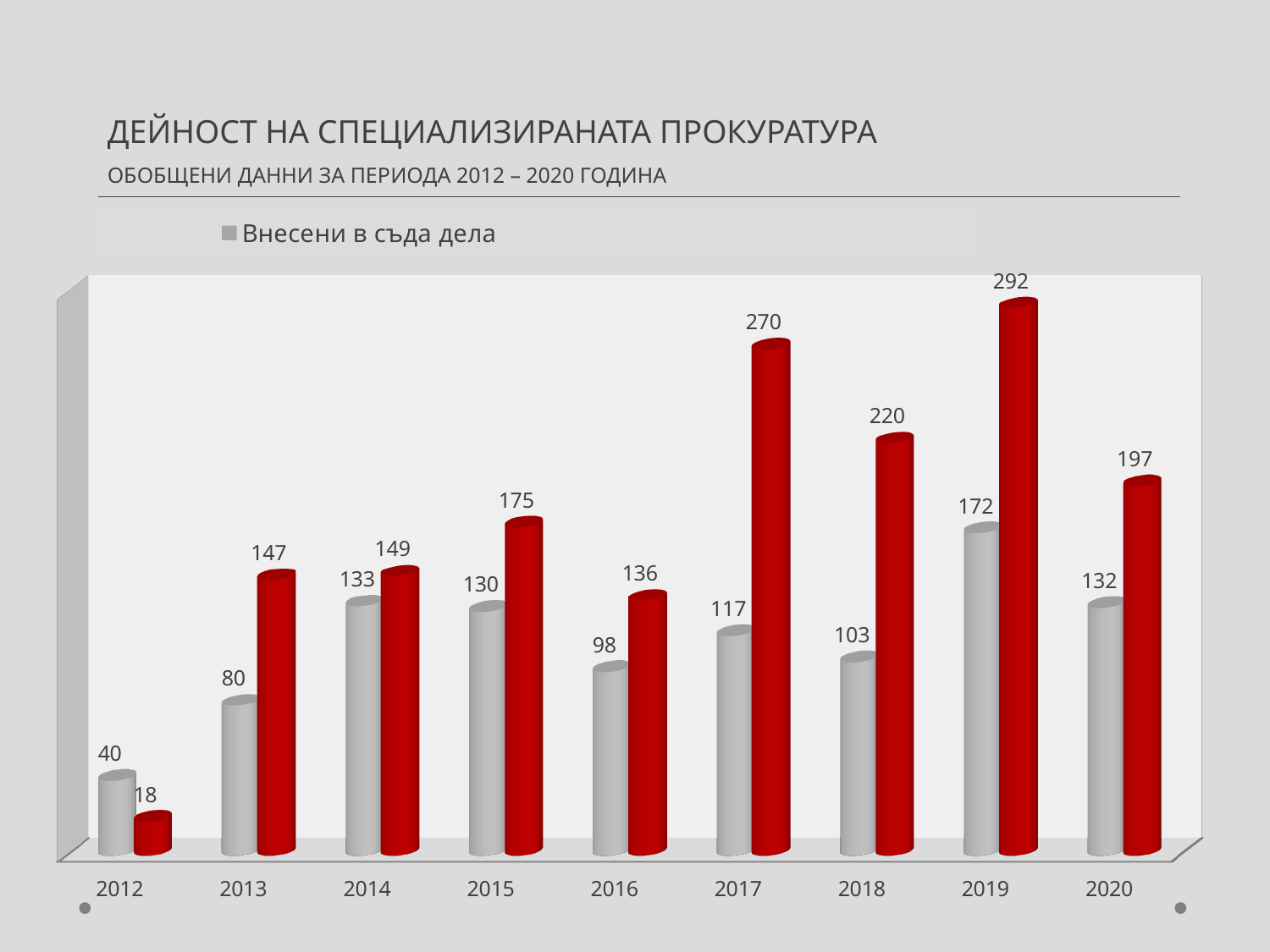
What is the value of the red bar for 2017? 270 In which year is the value of Внесени в съда дела lowest? 2012 How many years are shown on the x axis? 9 Does the value of Внесени в съда дела rise or fall from 2012 to 2014? Rise What is the value of Внесени в съда дела for 2016? 98 What kind of chart is shown on the slide? Bar chart What is the difference between the red bar and the Внесени в съда дела bar in 2019? 120 What is the legend entry shown above the chart? Внесени в съда дела How many series does the legend list? 1 In 2012, which is larger: the Внесени в съда дела bar or the red bar? Внесени в съда дела In which year is the red bar highest? 2019 What is the value of Внесени в съда дела for 2019? 172